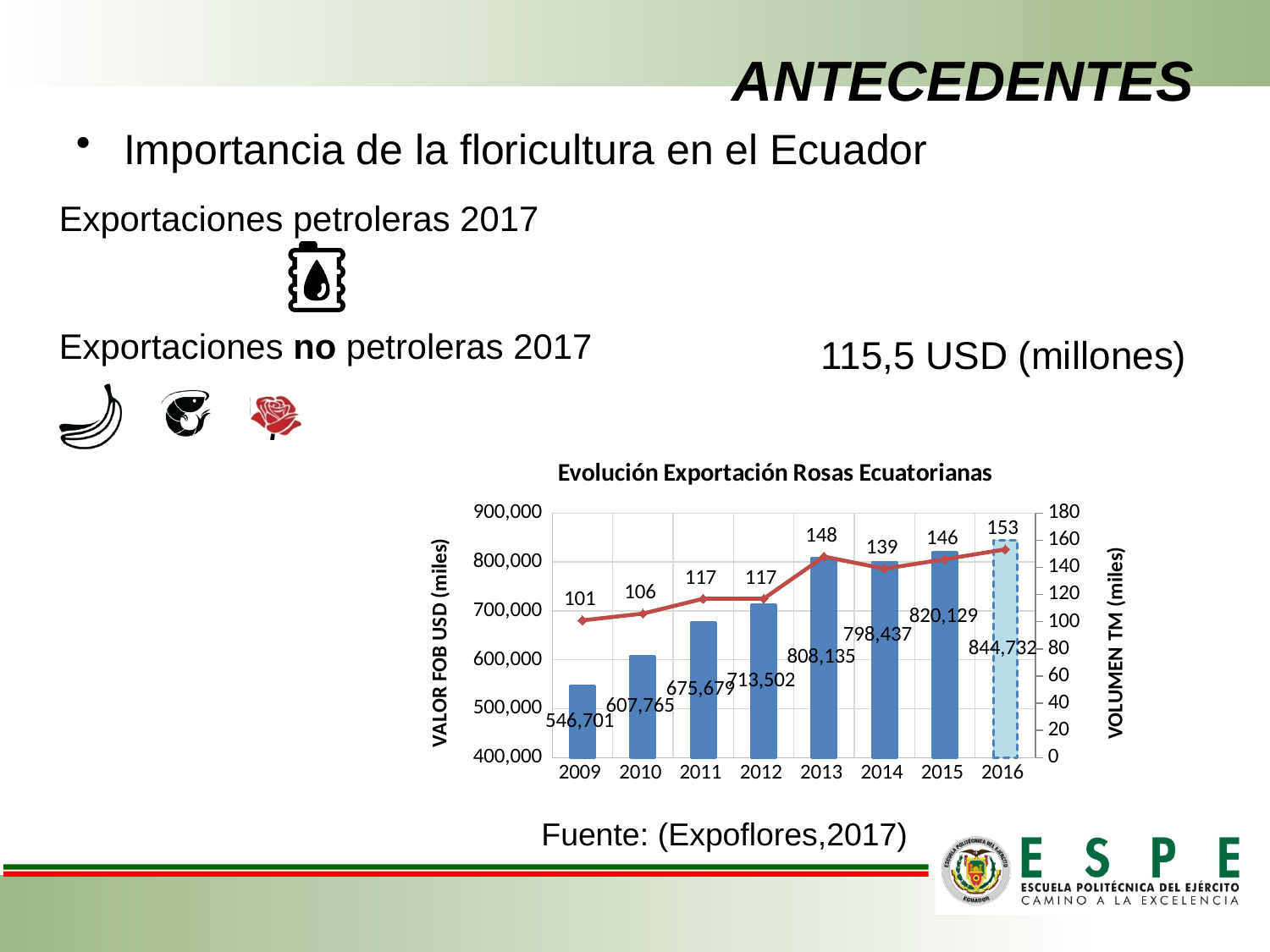
What is the VALOR FOB USD (miles) value for 2009? 546,701 What is the difference in VOLUMEN TM (miles) between 2016 and 2015? 7 What is the VALOR FOB USD (miles) value for 2016? 844,732 What is the VOLUMEN TM (miles) value for 2013? 148 How many years are shown on the x axis of the chart? 8 What is the title of the chart? Evolución Exportación Rosas Ecuatorianas What is the VOLUMEN TM (miles) value for 2010? 106 Which year has the larger VALOR FOB USD (miles), 2013 or 2014? 2013 What kind of chart is used to show the VALOR FOB USD (miles) values? Bar chart What is the difference in VALOR FOB USD (miles) between 2016 and 2009? 298,031 Which year has the lowest VOLUMEN TM (miles)? 2009 Which year has the highest VALOR FOB USD (miles)? 2016